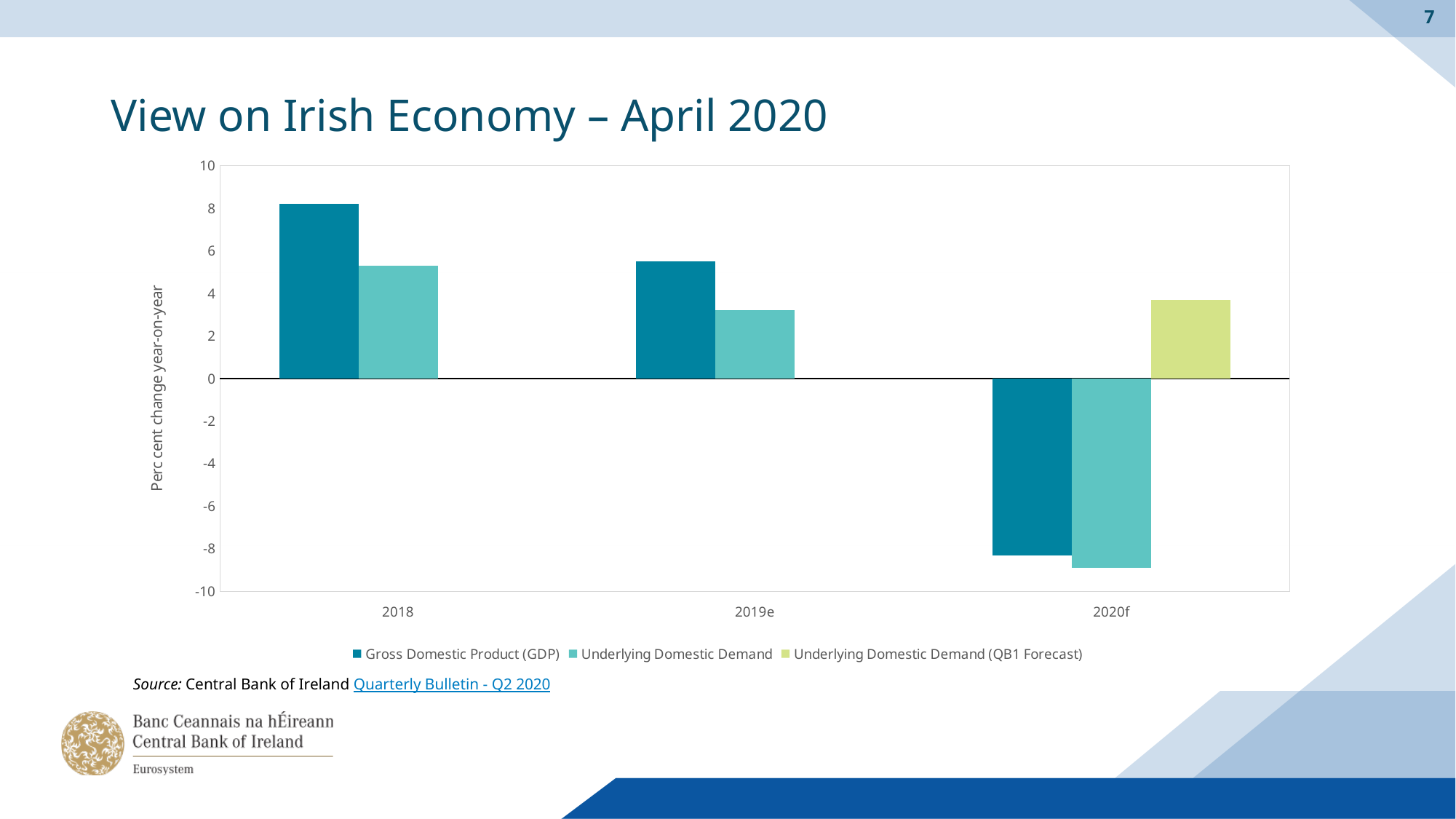
Is the Underlying Domestic Demand value for 2018 greater or less than 6? less Which year has the lowest Gross Domestic Product (GDP) value? 2020f Is the Gross Domestic Product (GDP) value for 2020f greater or less than -6? less Is the Gross Domestic Product (GDP) value for 2018 greater or less than 6? greater How many year categories are shown on the x axis? 3 How many series does the legend list? 3 What kind of chart is shown on the slide? bar chart Which year has the highest Gross Domestic Product (GDP) value? 2018 What is the label on the vertical axis of the chart? Perc cent change year-on-year Does the Gross Domestic Product (GDP) series rise or fall from 2018 to 2020f? fall